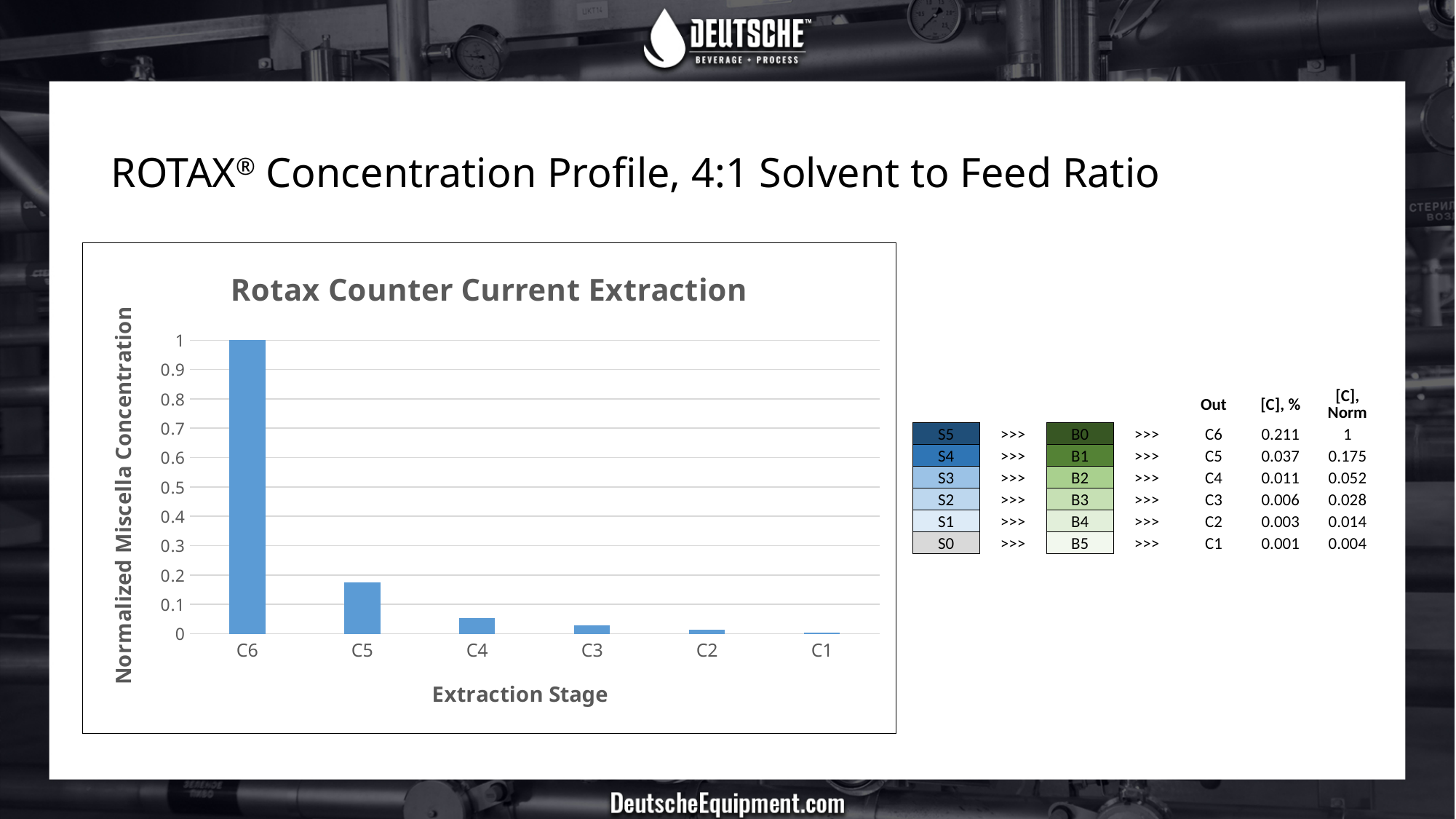
Is the value for C5 greater or less than 0.1? greater What is the title of the chart? Rotax Counter Current Extraction What is the normalized miscella concentration for stage C6? 1 How many extraction stages are plotted on the x axis of the chart? 6 Which extraction stage has the highest normalized miscella concentration? C6 What is the label of the chart's y axis? Normalized Miscella Concentration Is the value for C4 greater or less than 0.1? less Do the values rise or fall moving from C6 to C1 along the x axis? fall Which extraction stage has the lowest normalized miscella concentration? C1 Is the value for C5 greater or less than 0.2? less Which has the larger normalized miscella concentration, C4 or C3? C4 What kind of chart is shown on the slide? bar chart